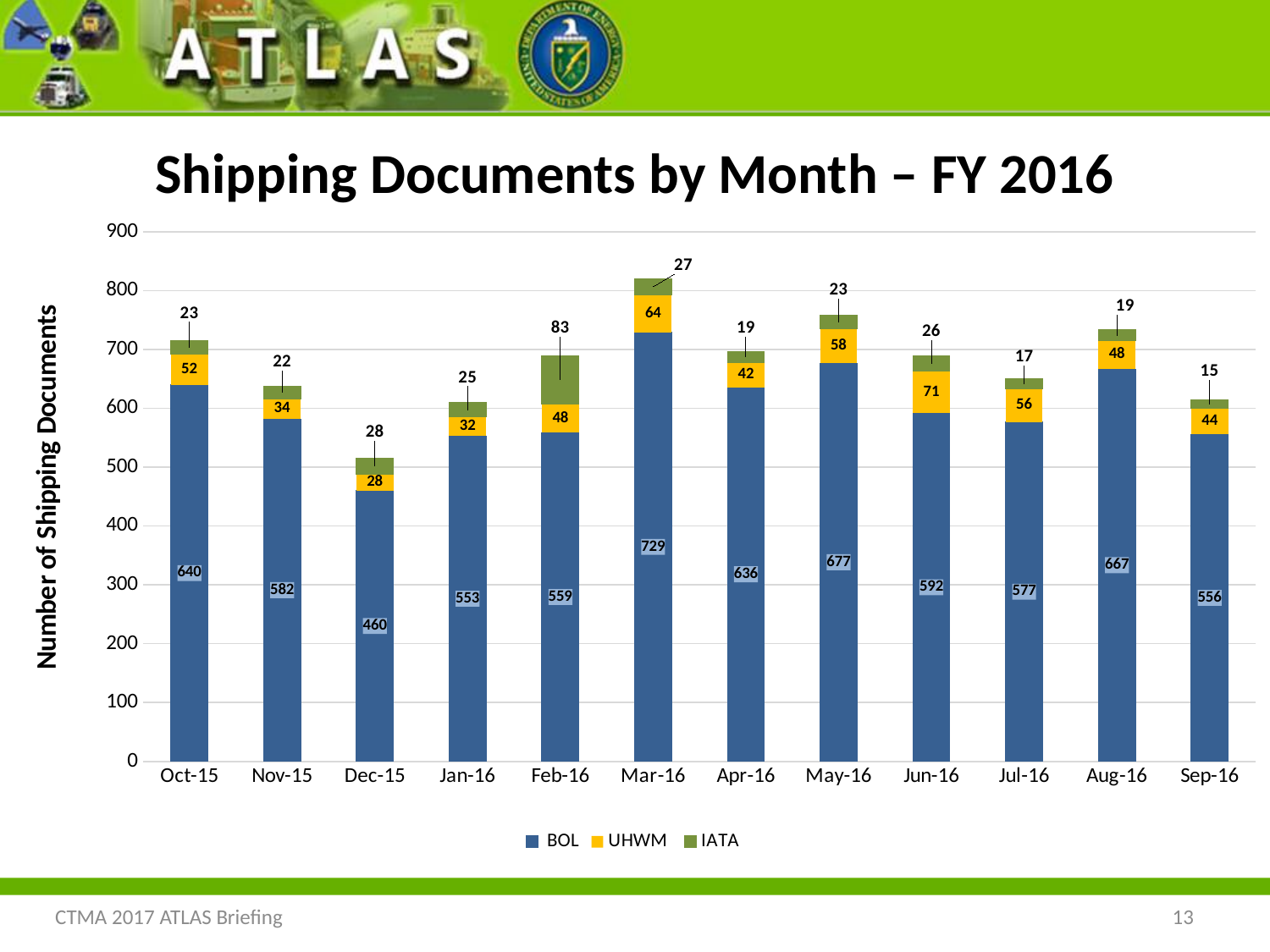
What is the UHWM value for Jun-16? 71 What is the BOL value for Mar-16? 729 How many series does the legend list? 3 What is the total of the stacked bar for Oct-15? 715 What is the title of the chart? Shipping Documents by Month – FY 2016 What is the IATA value for Feb-16? 83 Which month has the highest BOL value? Mar-16 Is the BOL value for Aug-16 larger than the BOL value for Sep-16? Yes What type of chart is shown on the slide? Stacked bar chart What is the difference between the BOL values for Mar-16 and Dec-15? 269 Which month has the lowest BOL value? Dec-15 How many months are shown on the x axis? 12